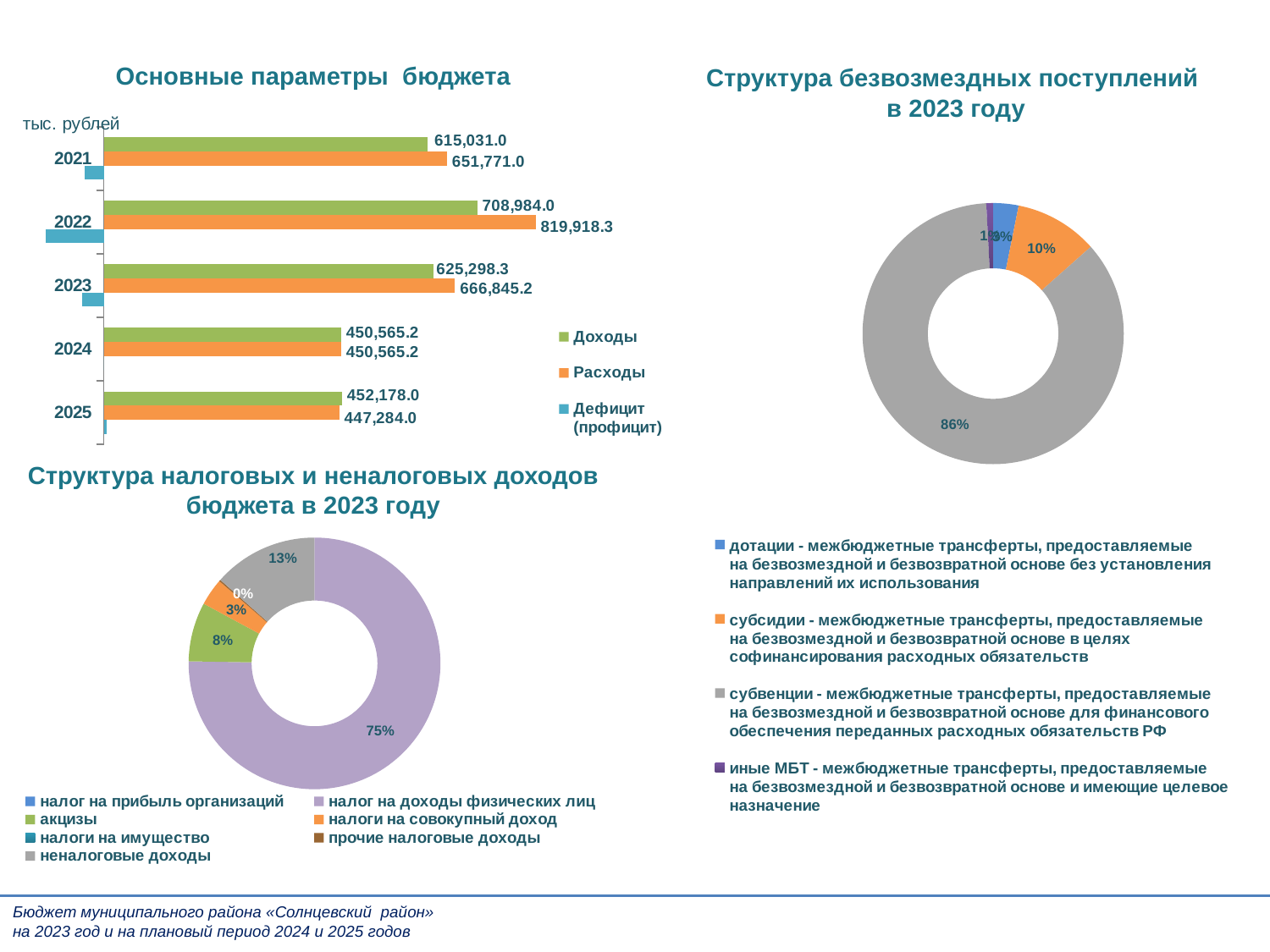
In the chart 'Структура безвозмездных поступлений в 2023 году', what share do субсидии have? 10% In the chart 'Основные параметры бюджета', what is the difference between Расходы and Доходы in 2021? 36,740.0 In the chart 'Основные параметры бюджета', which year has the highest Расходы value? 2022 In the chart 'Структура налоговых и неналоговых доходов бюджета в 2023 году', what share does 'налог на доходы физических лиц' have? 75% In the chart 'Структура безвозмездных поступлений в 2023 году', which category has the largest share? субвенции In the chart 'Основные параметры бюджета', which is larger in 2025, Доходы or Расходы? Доходы In the chart 'Основные параметры бюджета', what is the value of Доходы for 2022? 708,984.0 How many series does the legend of the chart 'Основные параметры бюджета' list? 3 In the chart 'Основные параметры бюджета', what is the value of Расходы for 2023? 666,845.2 What type of chart is 'Основные параметры бюджета'? Bar chart In the chart 'Структура налоговых и неналоговых доходов бюджета в 2023 году', what share does 'неналоговые доходы' have? 13% In the chart 'Основные параметры бюджета', which year has the lowest Доходы value? 2024